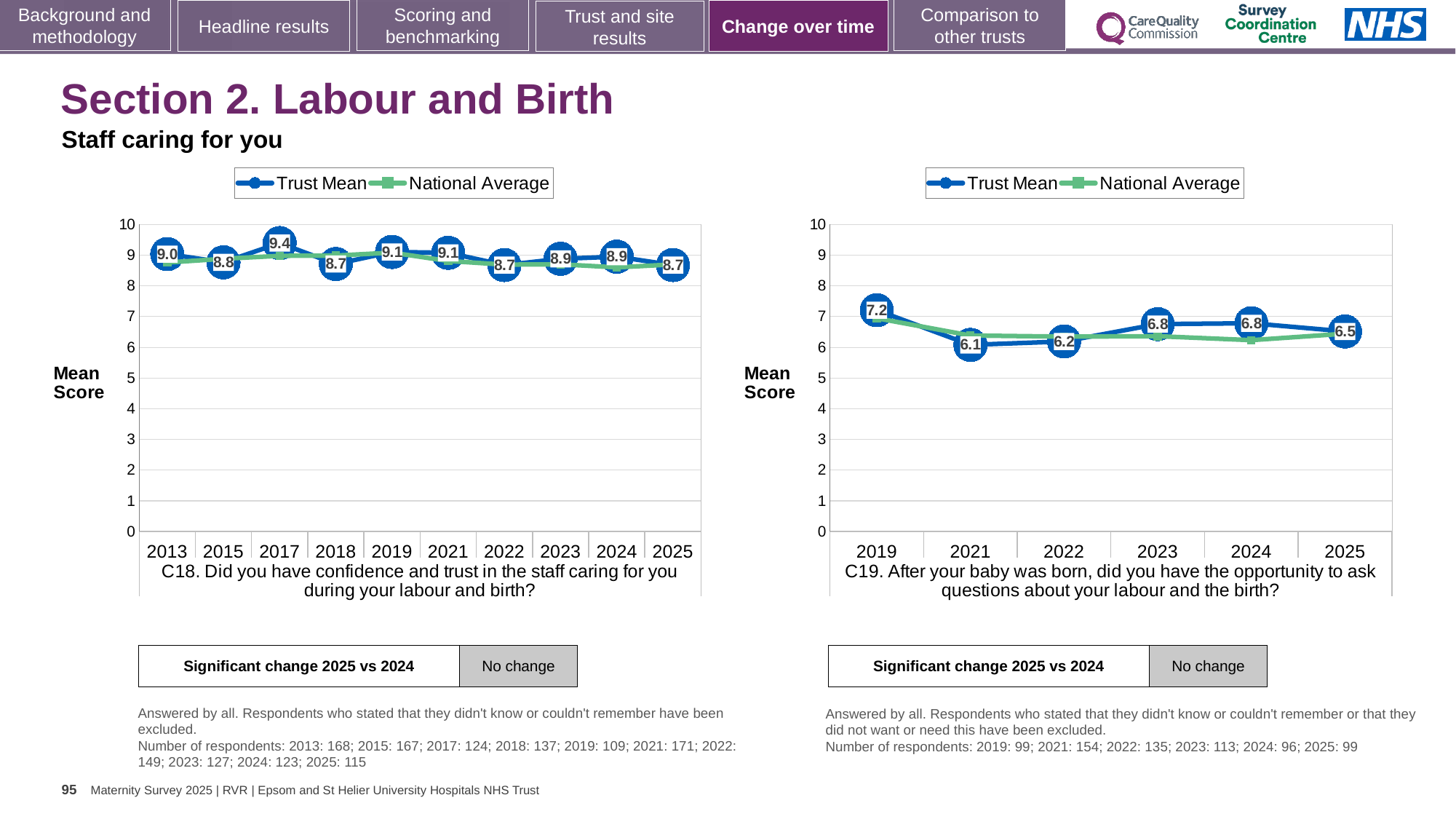
In the left chart (C18), what is the Trust Mean score for 2025? 8.7 In the right chart (C19), is the Trust Mean score for 2024 larger or smaller than the score for 2025? larger In the left chart (C18), what is the Trust Mean score for 2017? 9.4 In the right chart (C19), is the National Average value for 2019 greater or less than 6? greater In the left chart (C18), what is the difference between the Trust Mean scores for 2017 and 2018? 0.7 In the right chart (C19), what is the Trust Mean score for 2019? 7.2 In the left chart (C18), how many years are plotted on the x axis? 10 In the left chart (C18), which year has the highest Trust Mean score? 2017 In the right chart (C19), what is the difference between the Trust Mean scores for 2019 and 2025? 0.7 In the right chart (C19), which year has the lowest Trust Mean score? 2021 In the right chart (C19), which year has the highest Trust Mean score? 2019 How many series does the legend of the left chart (C18) list? 2